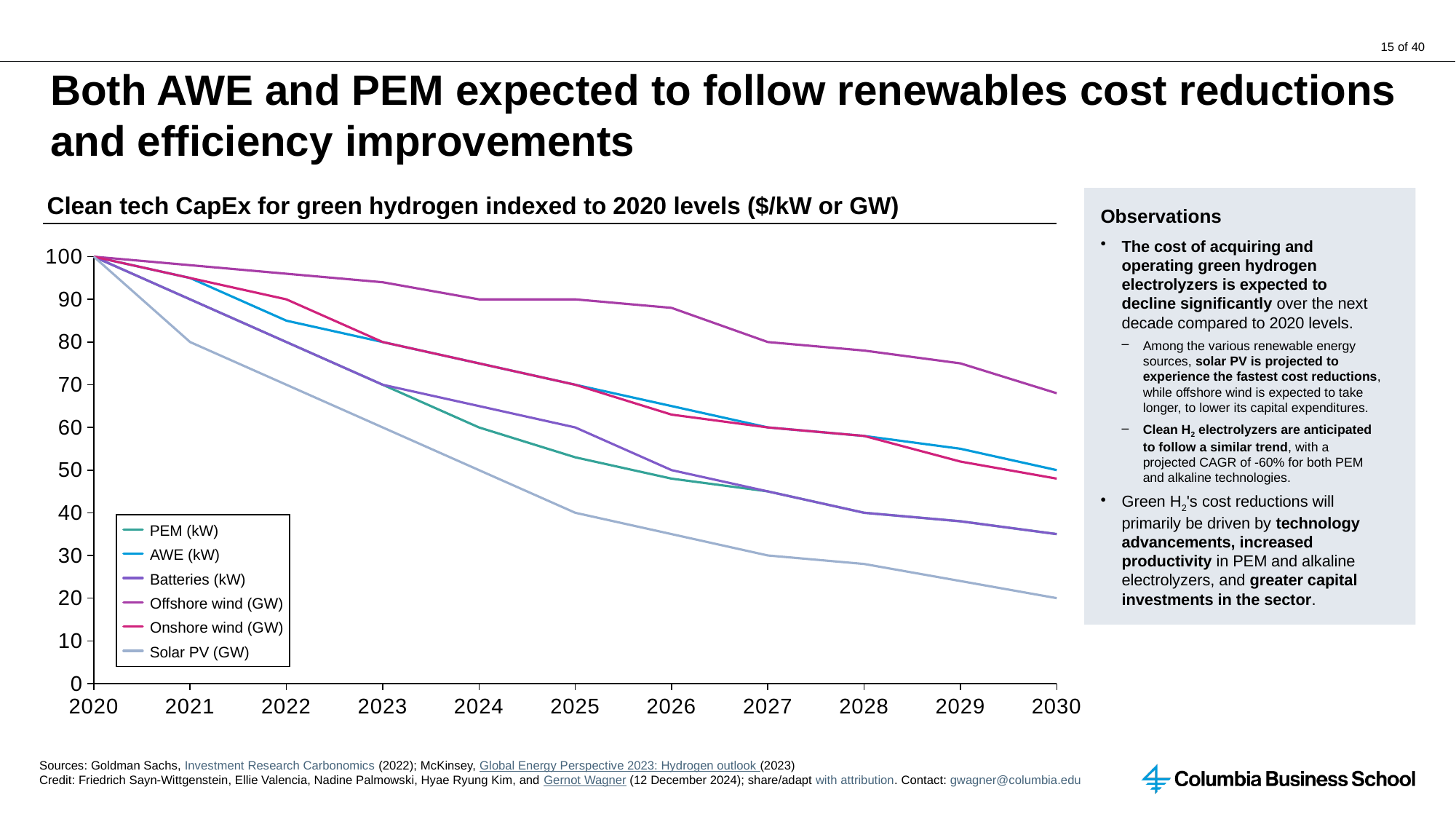
In 2025, which is larger: the value for Offshore wind (GW) or the value for Solar PV (GW)? Offshore wind (GW) Is the value for PEM (kW) in 2027 greater or less than 50? less How many years are plotted along the x axis of the chart? 11 Do the values for Solar PV (GW) rise or fall from 2020 to 2030? fall Which series has the highest value in 2030? Offshore wind (GW) How many series does the chart legend list? 6 What is the value for Offshore wind (GW) in 2027? 80 What is the value for all series in 2020? 100 Which series has the lowest value in 2030? Solar PV (GW) What is the value for Solar PV (GW) in 2030? 20 What kind of chart is shown on the slide? line chart Is the value for Offshore wind (GW) in 2030 greater or less than 60? greater